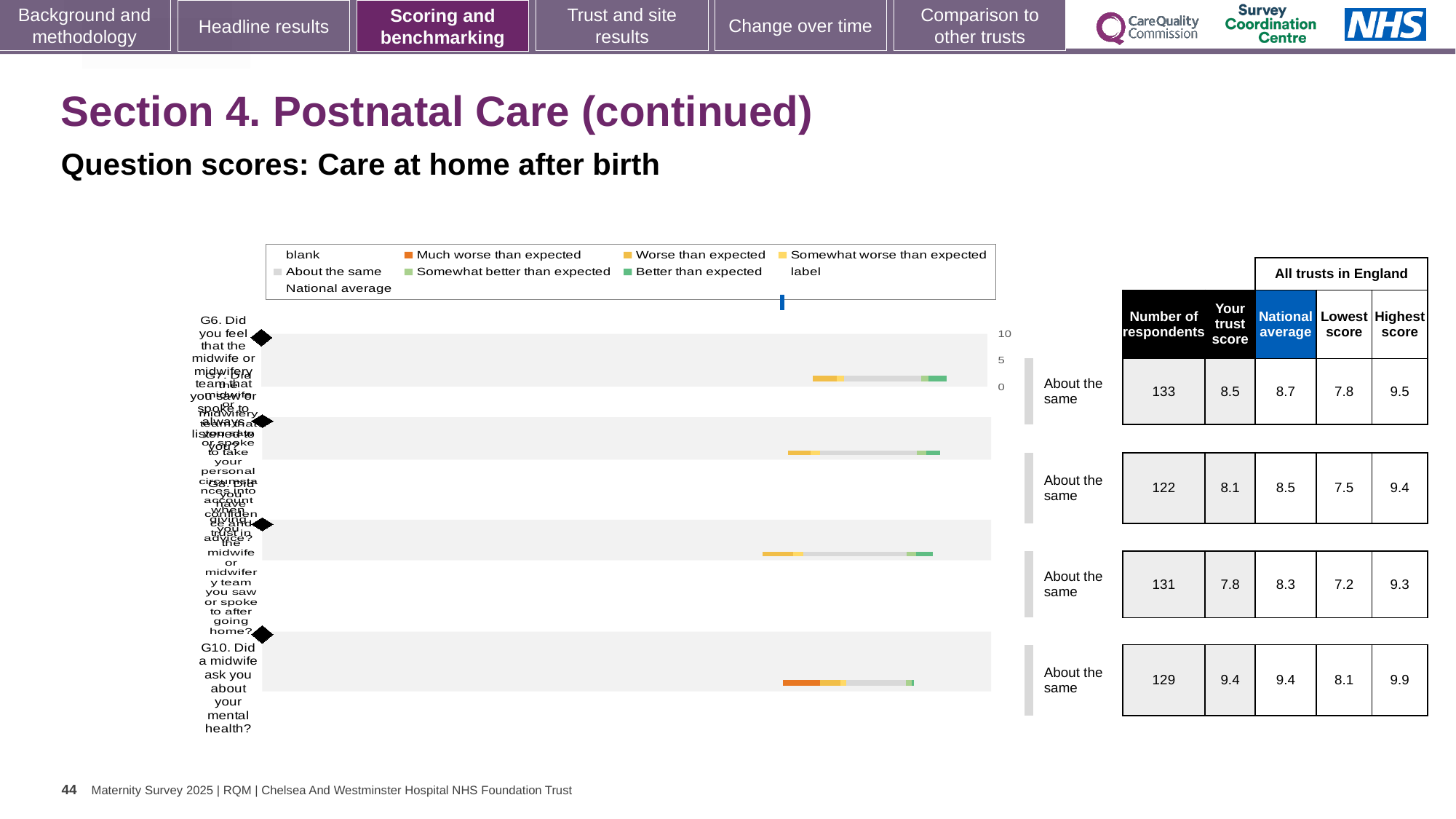
In the table beside the chart, what is the difference between the national average (8.7) and the trust score (8.5) in the top row? 0.2 How many questions (categories) are plotted in the chart? 4 In the table beside the chart, what is the lowest 'Your trust score' among the four rows? 7.8 In the table beside the chart, what is the highest 'Your trust score' among the four rows? 9.4 In the table beside the chart, what is the 'Your trust score' for the bottom row (G10. Did a midwife ask you about your mental health?)? 9.4 In the table beside the chart, what is the highest score for the bottom row (G10)? 9.9 Which colour does the legend use for 'Much worse than expected'? orange What benchmark label is shown next to each of the four bars in the chart? About the same In the table beside the chart, what is the number of respondents for the bottom row (G10)? 129 In the top row of the table, which is larger: the trust score or the national average? National average What is the highest tick value shown on the chart's axis? 10 What kind of chart is shown on the slide? bar chart